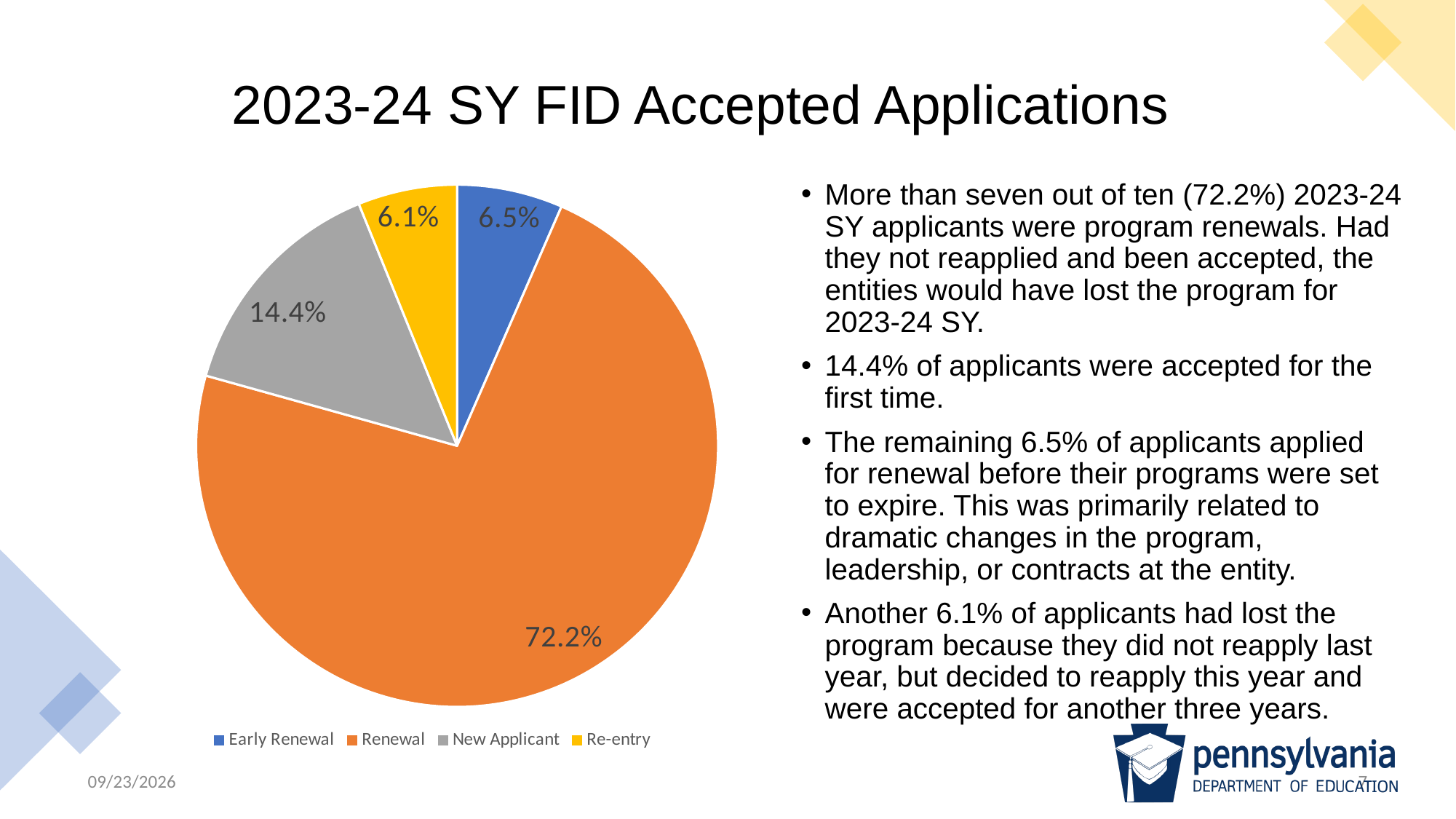
Which category has the smallest slice of the pie? Re-entry Which is larger, the New Applicant slice or the Early Renewal slice? New Applicant What kind of chart is shown on the slide? Pie chart What share of accepted applications were Re-entry? 6.1% How many categories does the pie chart show? 4 What is the difference in percentage points between Renewal and New Applicant? 57.8 Which category has the largest slice of the pie? Renewal What share of accepted applications were Renewals? 72.2% What is the title of the slide containing the pie chart? 2023-24 SY FID Accepted Applications What share of accepted applications were Early Renewals? 6.5% What colour represents Renewal in the pie chart? Orange What share of accepted applications were New Applicants? 14.4%